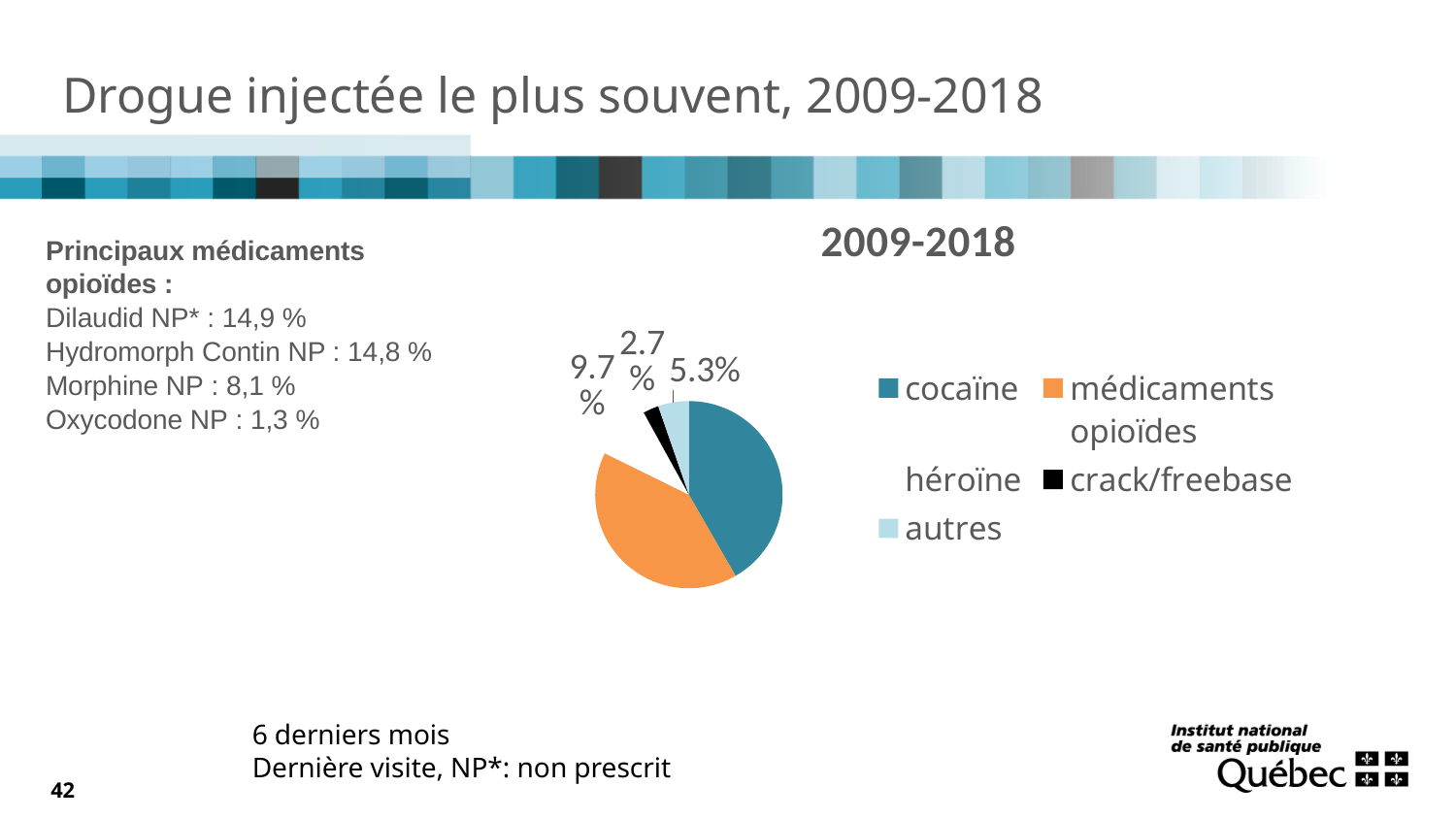
What colour represents crack/freebase in the pie chart? black How many categories does the legend of the pie chart list? 5 Which is larger in the pie chart, héroïne or autres? héroïne What share of the pie does héroïne represent? 9.7% What kind of chart is shown on the slide? pie chart What is the value shown for autres in the pie chart? 5.3% What is the difference between the héroïne and autres values in the pie chart? 4.4% Which category has the smallest slice in the pie chart? crack/freebase What is the title of the pie chart? 2009-2018 Which is larger in the pie chart, crack/freebase or autres? autres What is the value shown for crack/freebase in the pie chart? 2.7%